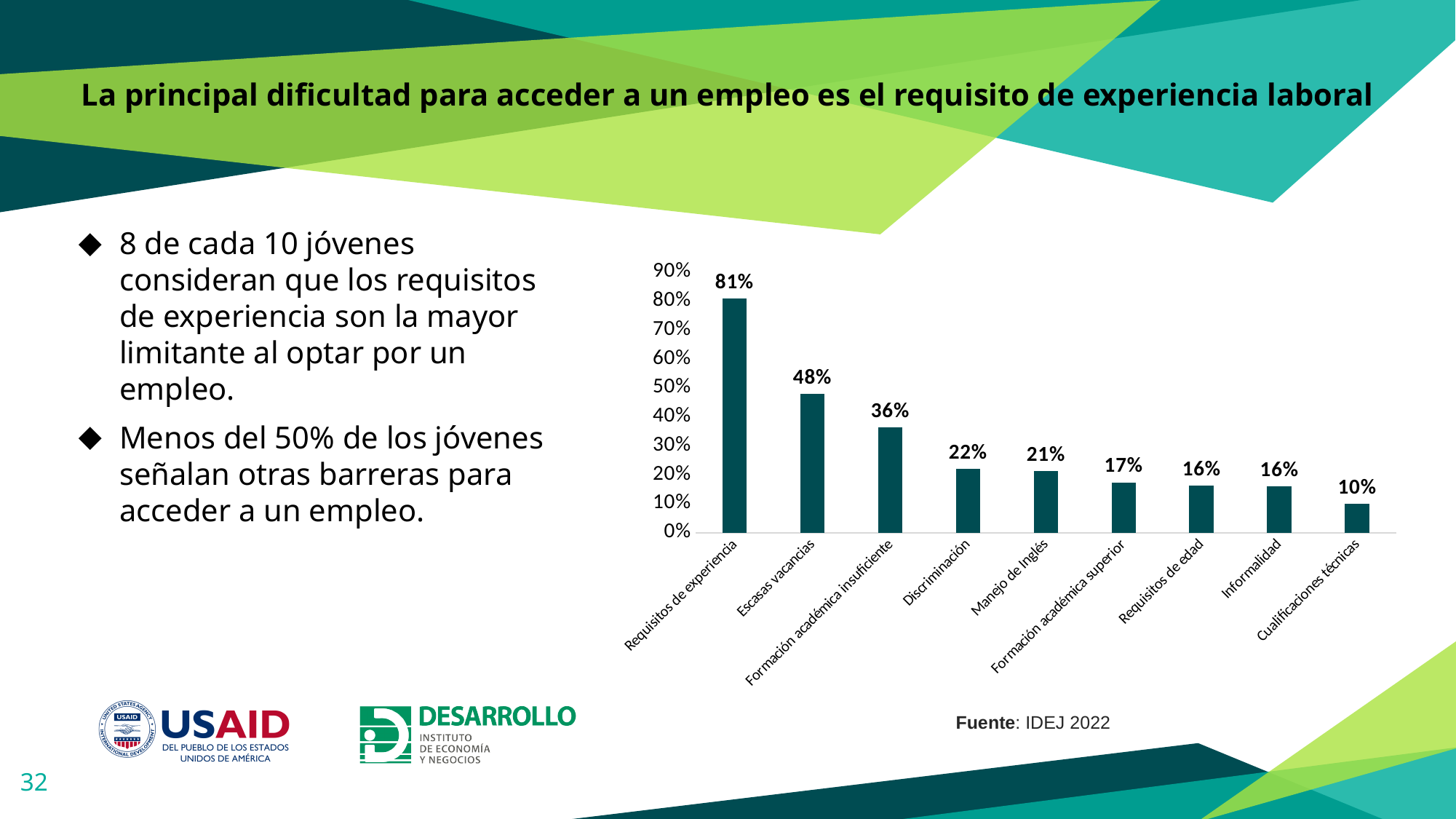
What is the value for Discriminación? 22% Do the values rise or fall from left to right along the x axis? Fall What kind of chart is shown on the slide? Bar chart Which category has the highest value? Requisitos de experiencia How many categories are shown in the chart? 9 Which is larger, the value for Formación académica insuficiente or the value for Manejo de Inglés? Formación académica insuficiente What is the value for Escasas vacancias? 48% What is the difference between the values for Requisitos de experiencia and Escasas vacancias? 33% Which category has the lowest value? Cualificaciones técnicas What is the value for Requisitos de experiencia? 81% What source is cited below the chart? IDEJ 2022 What is the value for Cualificaciones técnicas? 10%